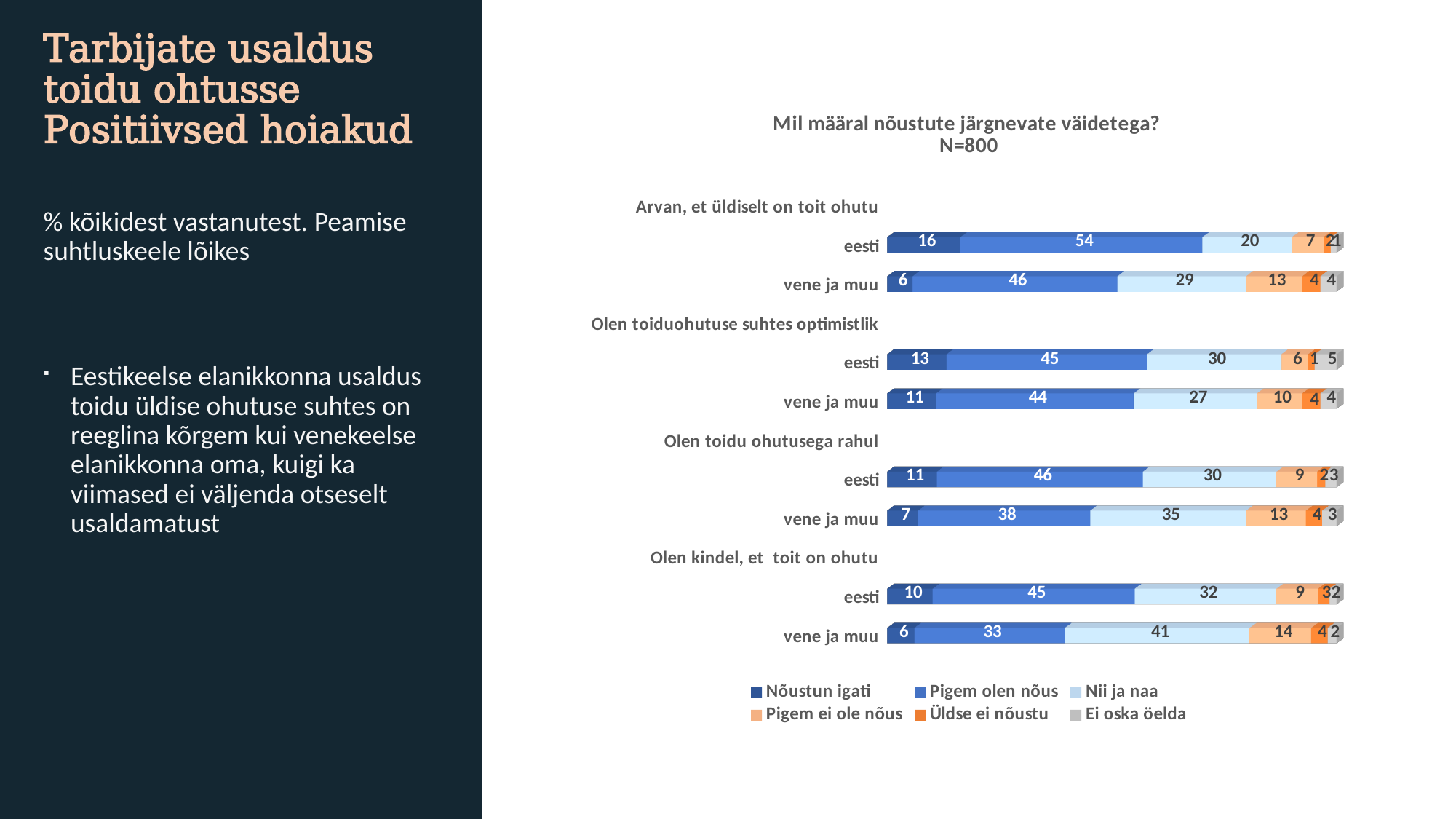
Under 'Olen toidu ohutusega rahul', which has the larger 'Nii ja naa' value, 'eesti' or 'vene ja muu'? vene ja muu What is the 'Pigem ei ole nõus' value for 'vene ja muu' under 'Olen toidu ohutusega rahul'? 13 What is the 'Pigem olen nõus' value for 'eesti' under 'Arvan, et üldiselt on toit ohutu'? 54 What kind of chart is shown on the slide? Stacked bar chart What is the 'Nii ja naa' value for 'vene ja muu' under 'Olen kindel, et toit on ohutu'? 41 Which bar has the highest 'Nõustun igati' value? eesti, Arvan, et üldiselt on toit ohutu How many series does the legend list? 6 Which bar has the lowest 'Pigem olen nõus' value? vene ja muu, Olen kindel, et toit on ohutu How many bars are plotted in the chart? 8 What is the difference between the 'Pigem olen nõus' values for 'eesti' and 'vene ja muu' under 'Arvan, et üldiselt on toit ohutu'? 8 What is the 'Nõustun igati' value for 'eesti' under 'Olen toiduohutuse suhtes optimistlik'? 13 What is the N stated in the chart title? N=800